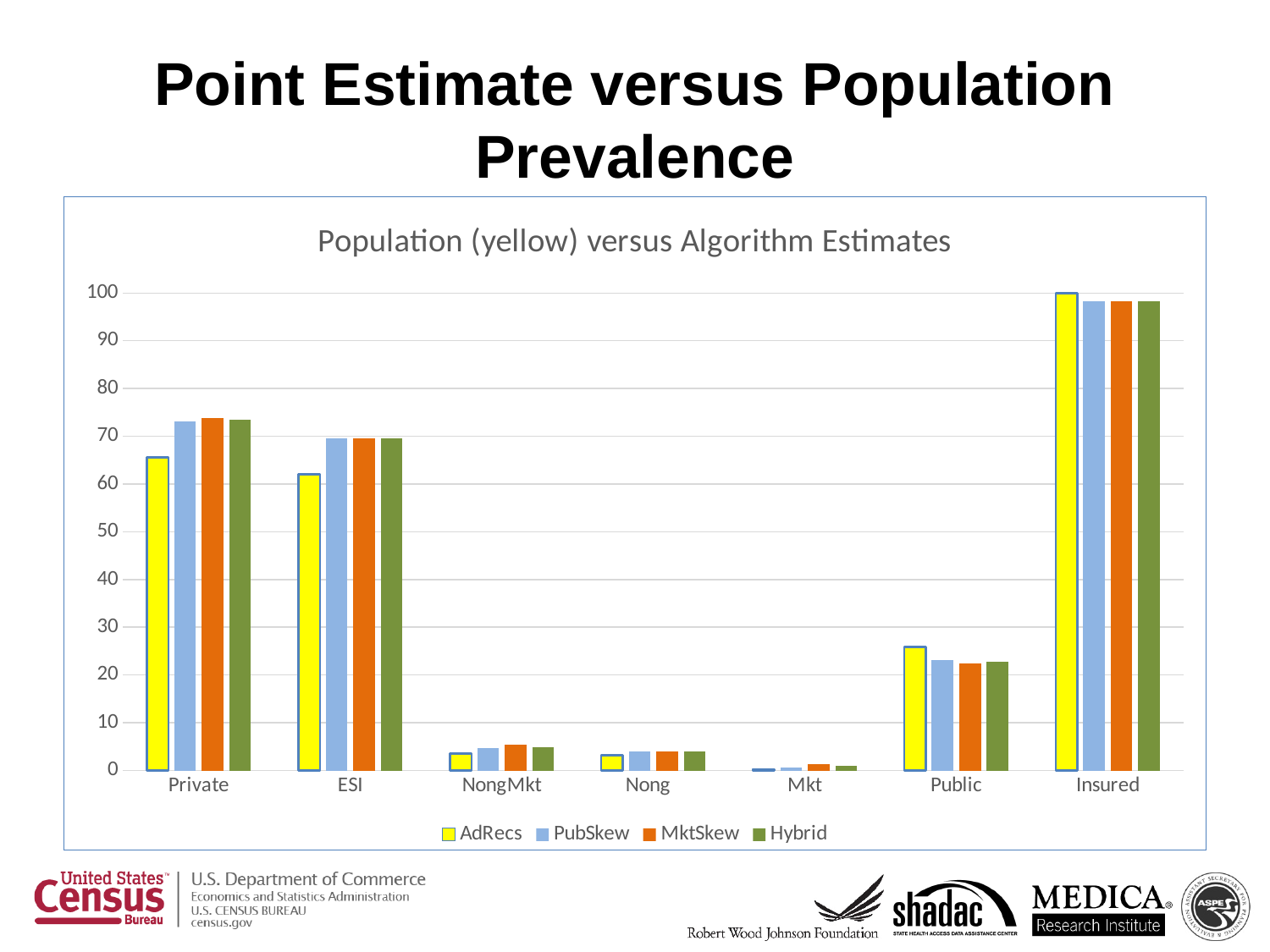
Is the Hybrid value for NongMkt greater or less than 10? less What kind of chart is shown on the slide? bar chart For the Public category, which is larger: the AdRecs value or the MktSkew value? AdRecs How many categories are shown along the x axis of the chart? 7 What is the title of the chart? Population (yellow) versus Algorithm Estimates How many series does the chart's legend list? 4 Which category has the highest values in the chart? Insured Is the AdRecs value for Public greater or less than 20? greater For the Private category, which is larger: the AdRecs value or the Hybrid value? Hybrid Which category has the lowest values in the chart? Mkt Is the AdRecs value for Private greater or less than 60? greater